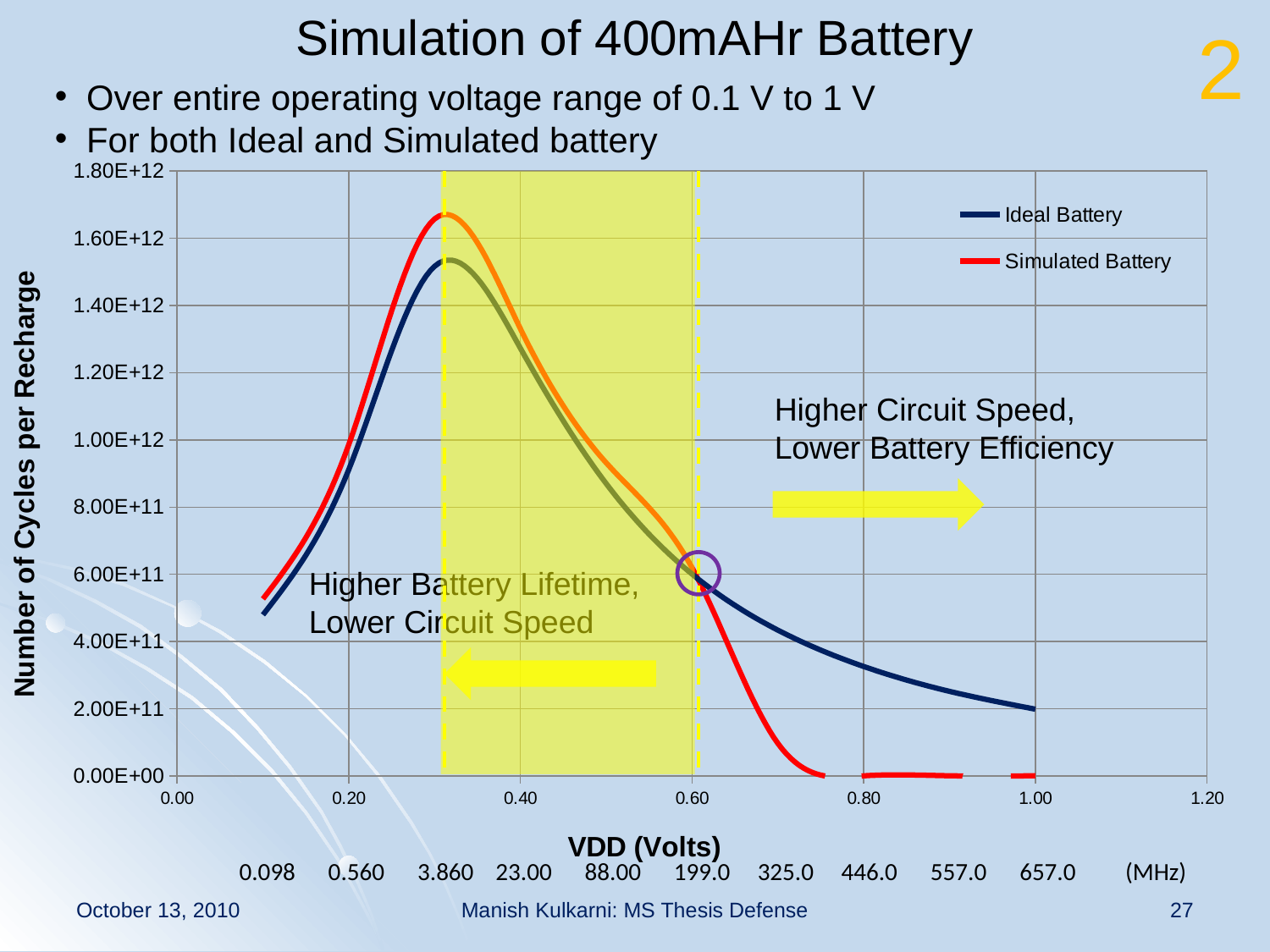
At VDD = 0.80 V, which series has the higher number of cycles per recharge, Ideal Battery or Simulated Battery? Ideal Battery Is the peak value of the Simulated Battery curve greater or less than 1.60E+12? greater What kind of chart is shown on the slide? line chart Does the Ideal Battery curve rise or fall as VDD increases from 0.40 V to 1.00 V? fall Is the peak value of the Ideal Battery curve greater or less than 1.40E+12? greater Which series reaches the higher peak number of cycles per recharge? Simulated Battery Which series is drawn in red in the chart? Simulated Battery Is the peak value of the Ideal Battery curve greater or less than 1.60E+12? less At VDD = 0.40 V, which series has the higher number of cycles per recharge, Ideal Battery or Simulated Battery? Simulated Battery What is the title of the x axis of the chart? VDD (Volts) How many series does the chart legend list? 2